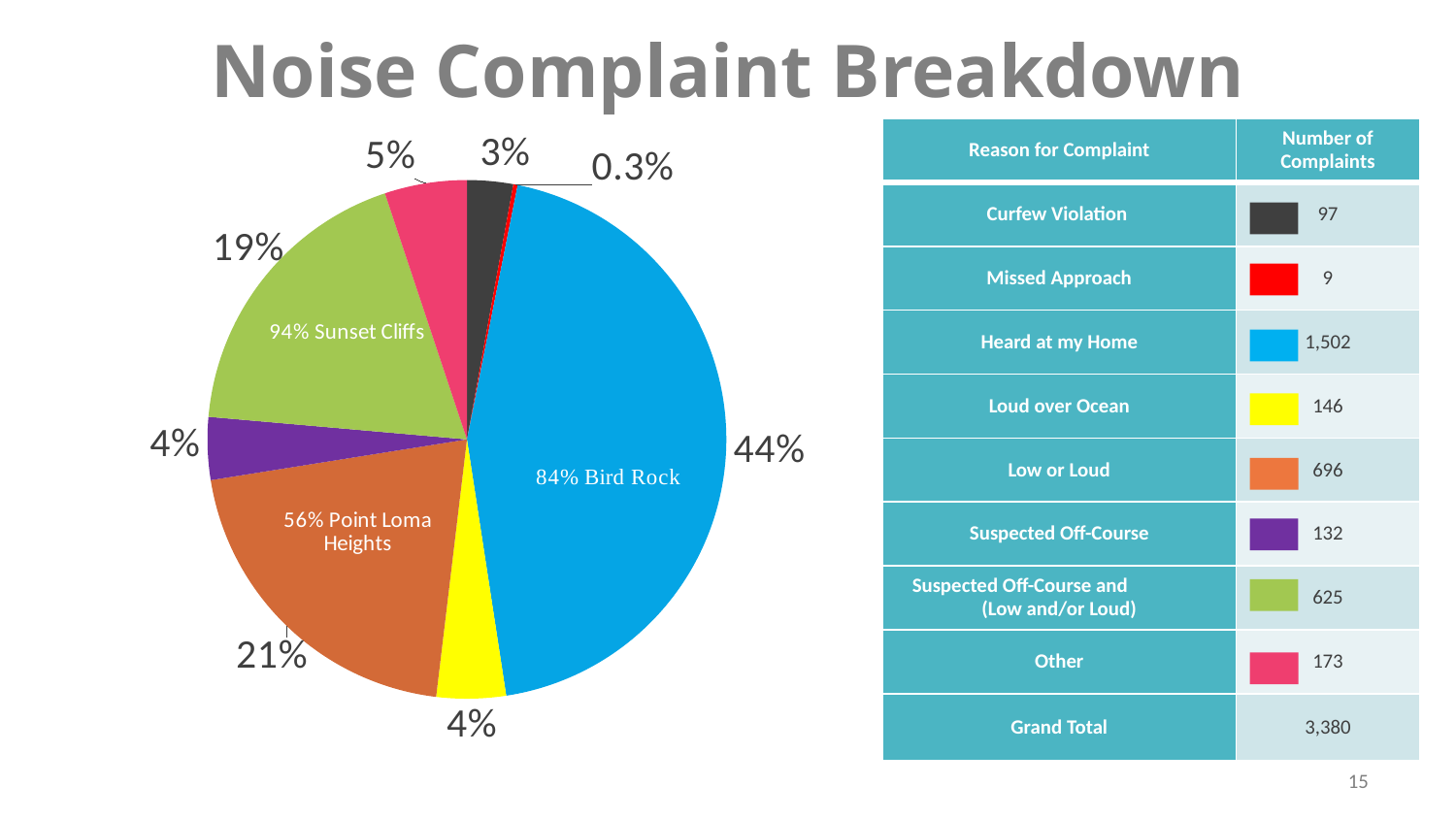
What share of the pie does the largest slice (blue, Heard at my Home) represent? 44% How many slices does the pie chart have? 8 What kind of chart is shown on the slide? pie chart What share of the pie does the green slice (Suspected Off-Course and Low and/or Loud) represent? 19% What is the difference in percentage points between the blue slice (44%) and the orange slice (21%)? 23 percentage points What share of the pie does the orange slice (Low or Loud) represent? 21% What is the title of the slide containing the pie chart? Noise Complaint Breakdown Which is larger in the pie chart: the pink slice (Other) or the dark gray slice (Curfew Violation)? Other (5%) Which slice of the pie chart is the smallest? Missed Approach (0.3%) What text label is printed inside the blue slice of the pie chart? 84% Bird Rock Which slice of the pie chart is the largest? Heard at my Home (44%)